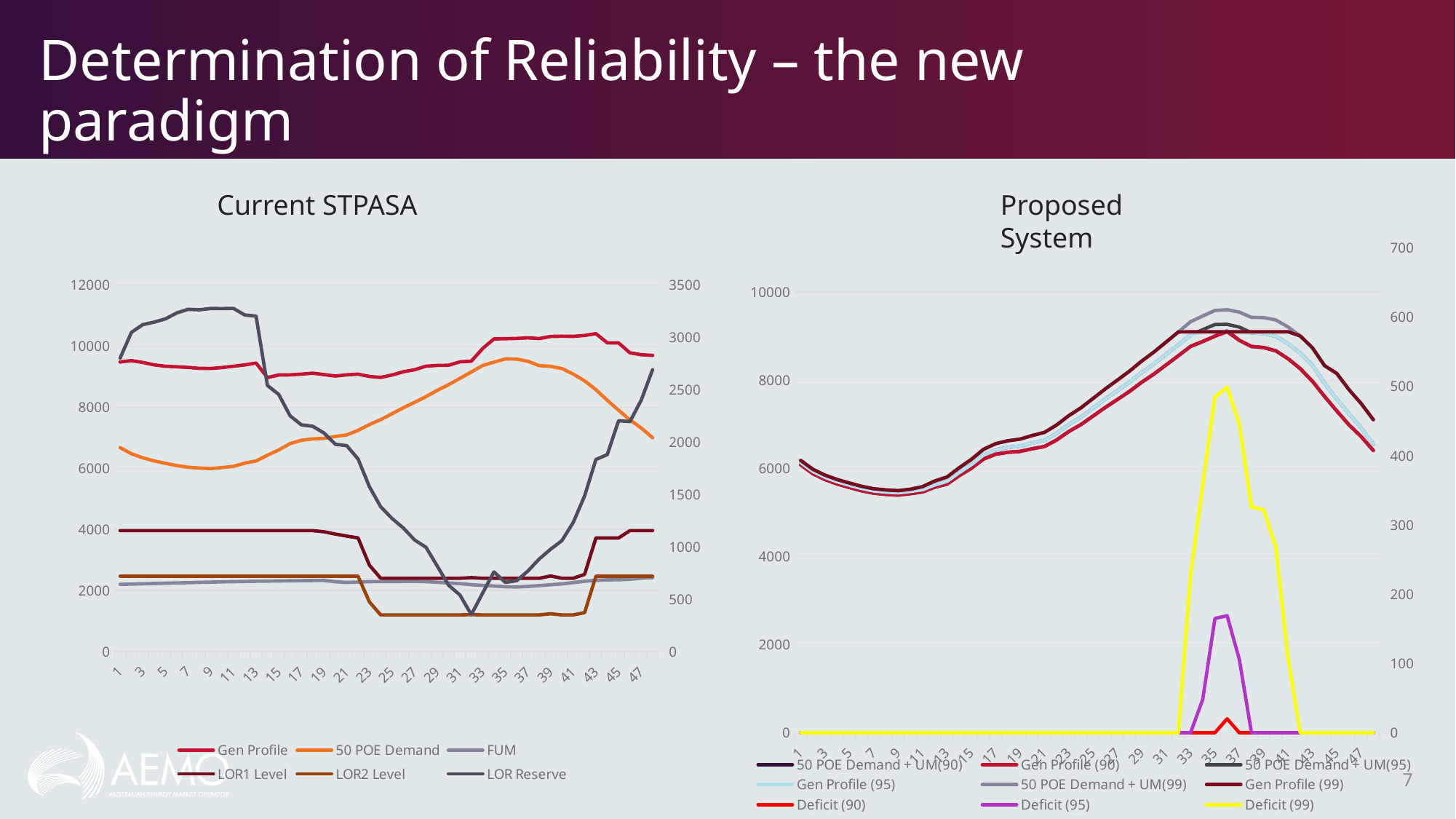
How many series does the legend of the Current STPASA chart list? 6 In the Current STPASA chart, is the value of LOR2 Level at x = 25 greater or less than 2000 on the left axis? less In the Current STPASA chart, is the value of Gen Profile at x = 1 greater or less than 8000 on the left axis? greater In the Current STPASA chart, is the value of 50 POE Demand at x = 1 greater or less than 6000 on the left axis? greater What is the title of the chart on the left side of the slide? Current STPASA What type of chart is the Current STPASA chart? line chart In the Current STPASA chart, at x = 1, which is larger: Gen Profile or 50 POE Demand? Gen Profile How many series does the legend of the Proposed System chart list? 9 In the Proposed System chart, which deficit series reaches the highest peak: Deficit (90), Deficit (95) or Deficit (99)? Deficit (99) In the Proposed System chart, does Gen Profile (90) rise or fall between x = 9 and x = 35? rise In the Current STPASA chart, does LOR Reserve rise or fall between x = 13 and x = 31? fall